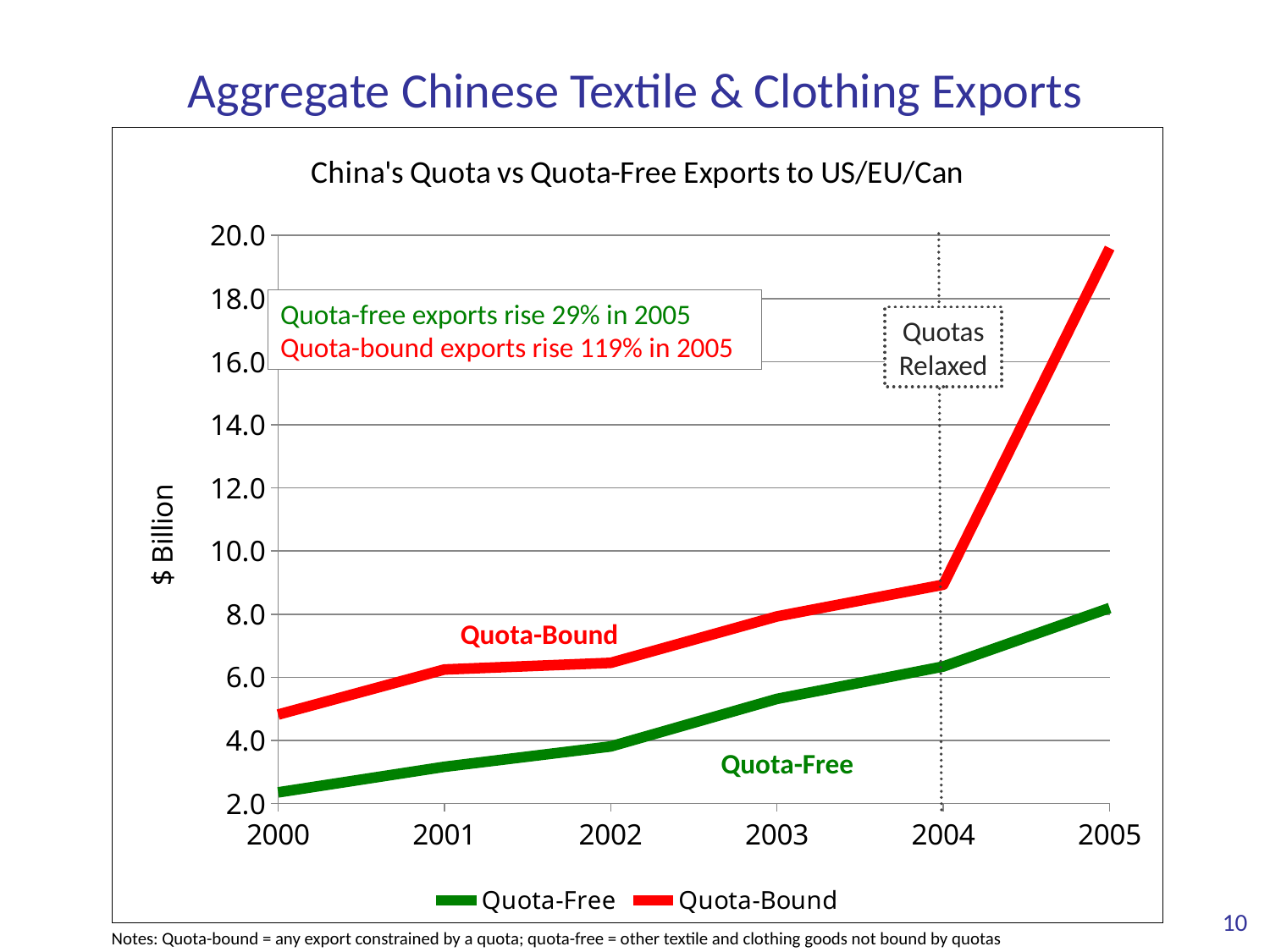
Is the Quota-Bound value for 2005 greater or less than 18.0? greater Does the Quota-Free series rise or fall from 2000 to 2005? Rise Does the Quota-Bound series rise or fall from 2000 to 2005? Rise How many series does the legend list? 2 How many years are plotted along the x axis? 6 In 2005, which series has the larger value, Quota-Free or Quota-Bound? Quota-Bound In which year is the Quota-Bound series at its highest? 2005 Is the Quota-Free value for 2000 greater or less than 4.0? less Is the Quota-Bound value for 2004 greater or less than 10.0? less In which year is the Quota-Free series at its lowest? 2000 What kind of chart is shown on the slide? Line chart